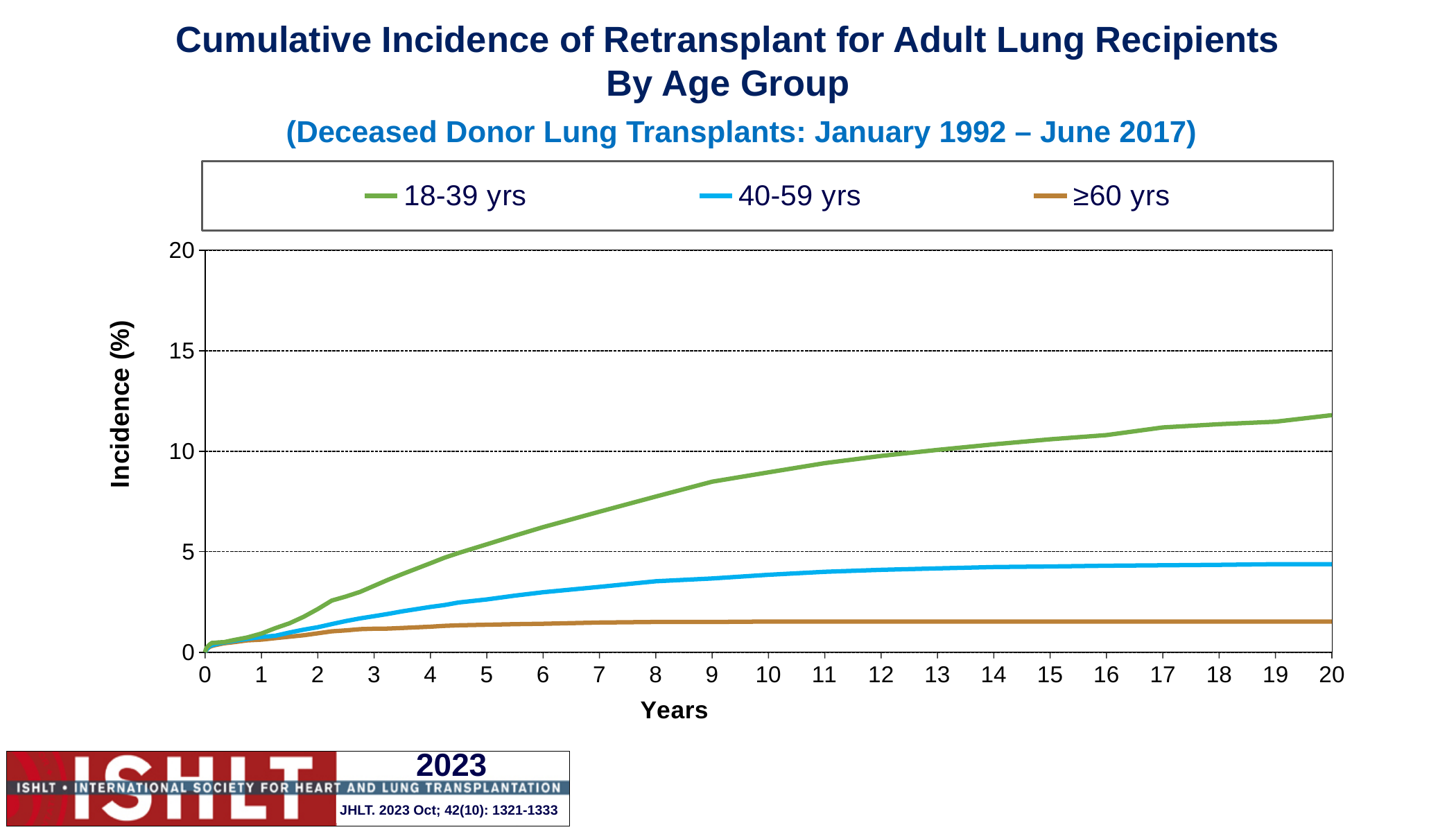
What colour is the line for the ≥60 yrs group? brown What is the label of the y axis? Incidence (%) Which age group has the highest cumulative incidence of retransplant at 20 years? 18-39 yrs How many series does the legend list? 3 Which age group has the lowest cumulative incidence of retransplant at 20 years? ≥60 yrs Is the value for the 18-39 yrs group at 20 years greater or less than 10? greater Does the cumulative incidence for the 18-39 yrs group rise or fall as years increase? rise Is the value for the 40-59 yrs group at 20 years greater or less than 5? less What kind of chart is shown on the slide? line chart Which is larger at 10 years: the value for 18-39 yrs or the value for 40-59 yrs? 18-39 yrs Is the value for the ≥60 yrs group at 10 years greater or less than 5? less